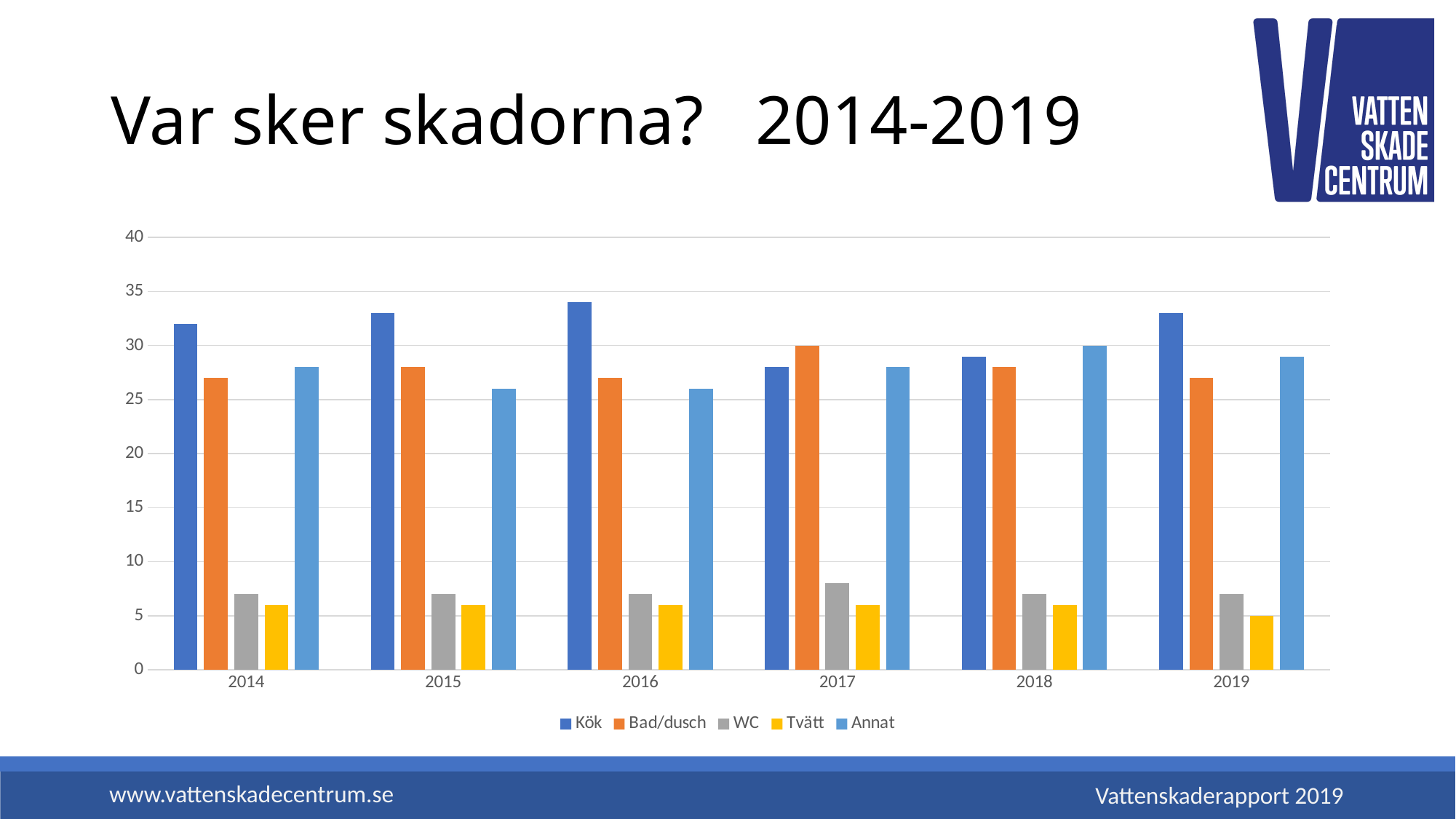
What kind of chart is shown on the slide? bar chart Is the value for WC in 2017 greater or less than 10? less In 2017, which is larger: Kök or Bad/dusch? Bad/dusch Which series has the highest value in 2016? Kök In 2014, which is larger: Kök or Bad/dusch? Kök How many series does the legend list? 5 How many years are shown on the x axis? 6 What are the legend entries of the chart? Kök, Bad/dusch, WC, Tvätt, Annat Is the value for Kök in 2016 greater or less than 30? greater Which series has the lowest value in 2019? Tvätt Is the value for Tvätt in 2014 greater or less than 10? less